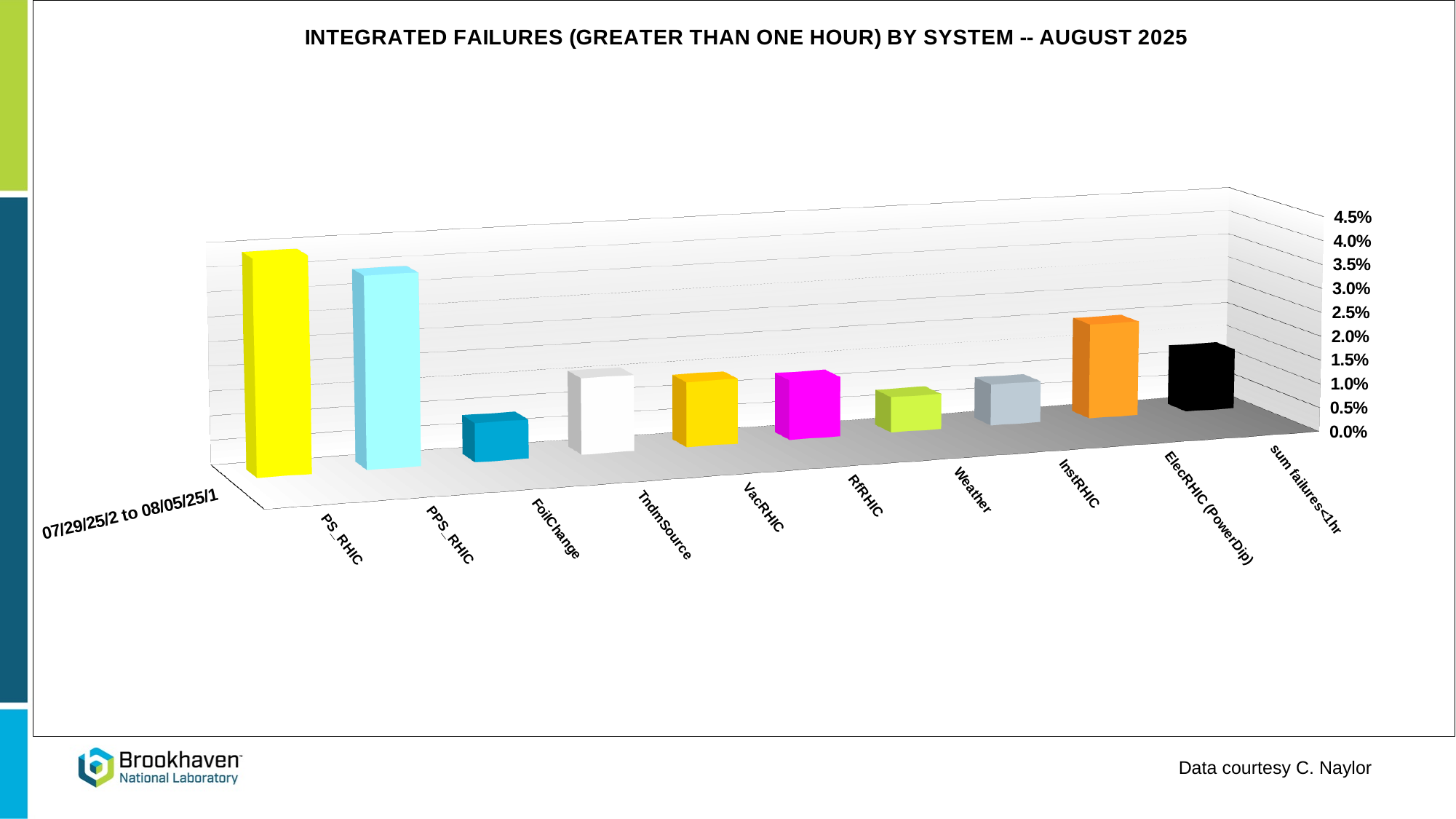
Which system has the highest integrated failure percentage? PS_RHIC How many system categories are plotted along the x axis? 10 What kind of chart is shown on the slide? bar chart Which is larger, the value for PS_RHIC or the value for PPS_RHIC? PS_RHIC Is the value for PS_RHIC greater or less than 2.0%? greater Is the value for ElecRHIC (PowerDip) greater or less than 1.0%? greater What is the title of the chart? INTEGRATED FAILURES (GREATER THAN ONE HOUR) BY SYSTEM -- AUGUST 2025 Is the value for FoilChange greater or less than 1.5%? less What is the highest value shown on the vertical axis? 4.5% How many data series does the chart show? 1 Which is larger, the value for PPS_RHIC or the value for FoilChange? PPS_RHIC